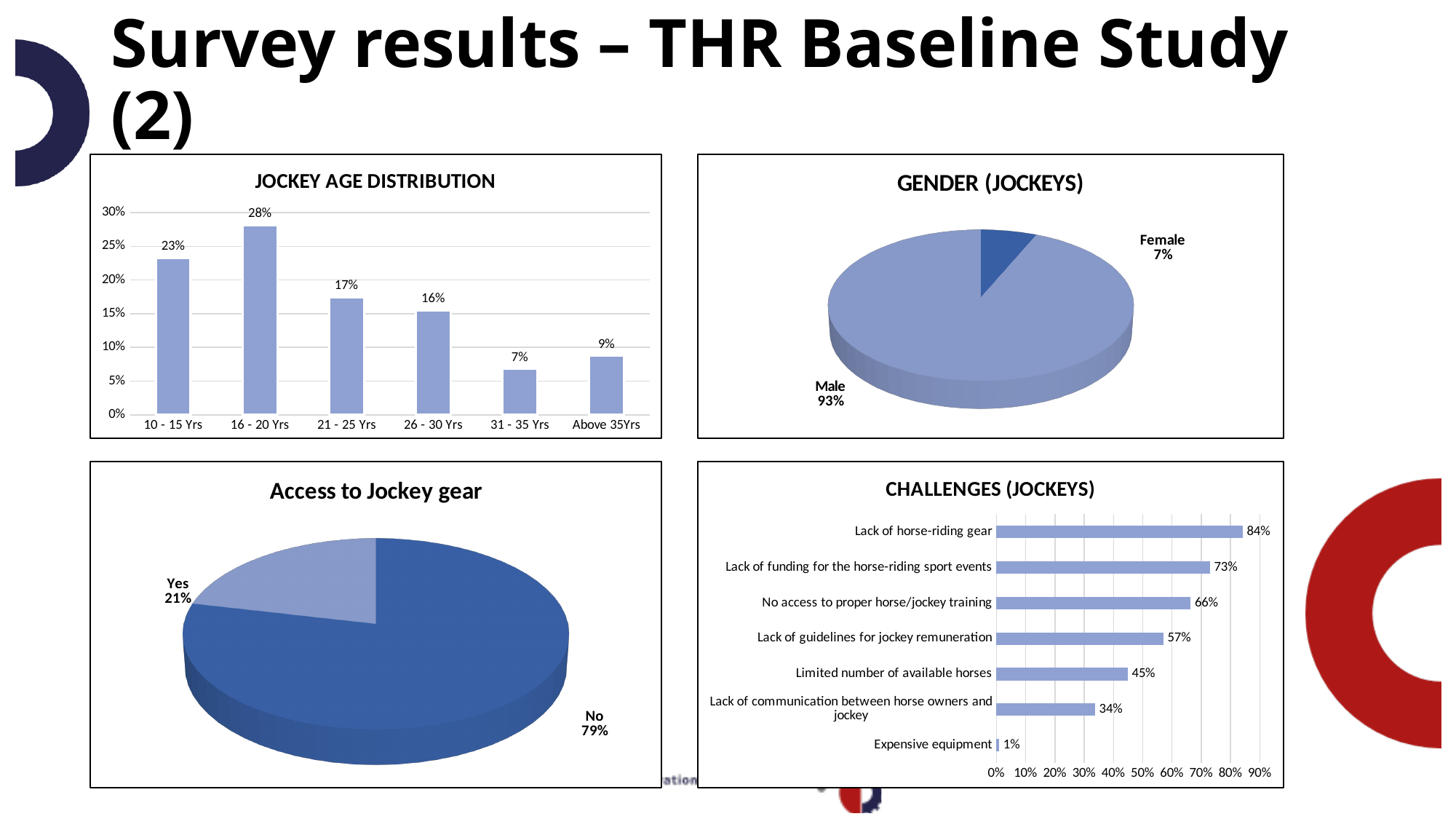
In the Access to Jockey gear chart, which is larger, Yes or No? No What kind of chart is the JOCKEY AGE DISTRIBUTION chart? Bar chart What kind of chart is the GENDER (JOCKEYS) chart? Pie chart In the JOCKEY AGE DISTRIBUTION chart, what is the value for 16 - 20 Yrs? 28% In the JOCKEY AGE DISTRIBUTION chart, which age group has the lowest value? 31 - 35 Yrs In the CHALLENGES (JOCKEYS) chart, what is the difference between Lack of horse-riding gear and Lack of funding for the horse-riding sport events? 11% In the JOCKEY AGE DISTRIBUTION chart, what is the difference between the values for 10 - 15 Yrs and 26 - 30 Yrs? 7% In the CHALLENGES (JOCKEYS) chart, which challenge has the highest value? Lack of horse-riding gear How many age groups are shown in the JOCKEY AGE DISTRIBUTION chart? 6 In the CHALLENGES (JOCKEYS) chart, what is the value for Limited number of available horses? 45% In the Access to Jockey gear chart, what share answered No? 79% In the GENDER (JOCKEYS) chart, what share is Female? 7%